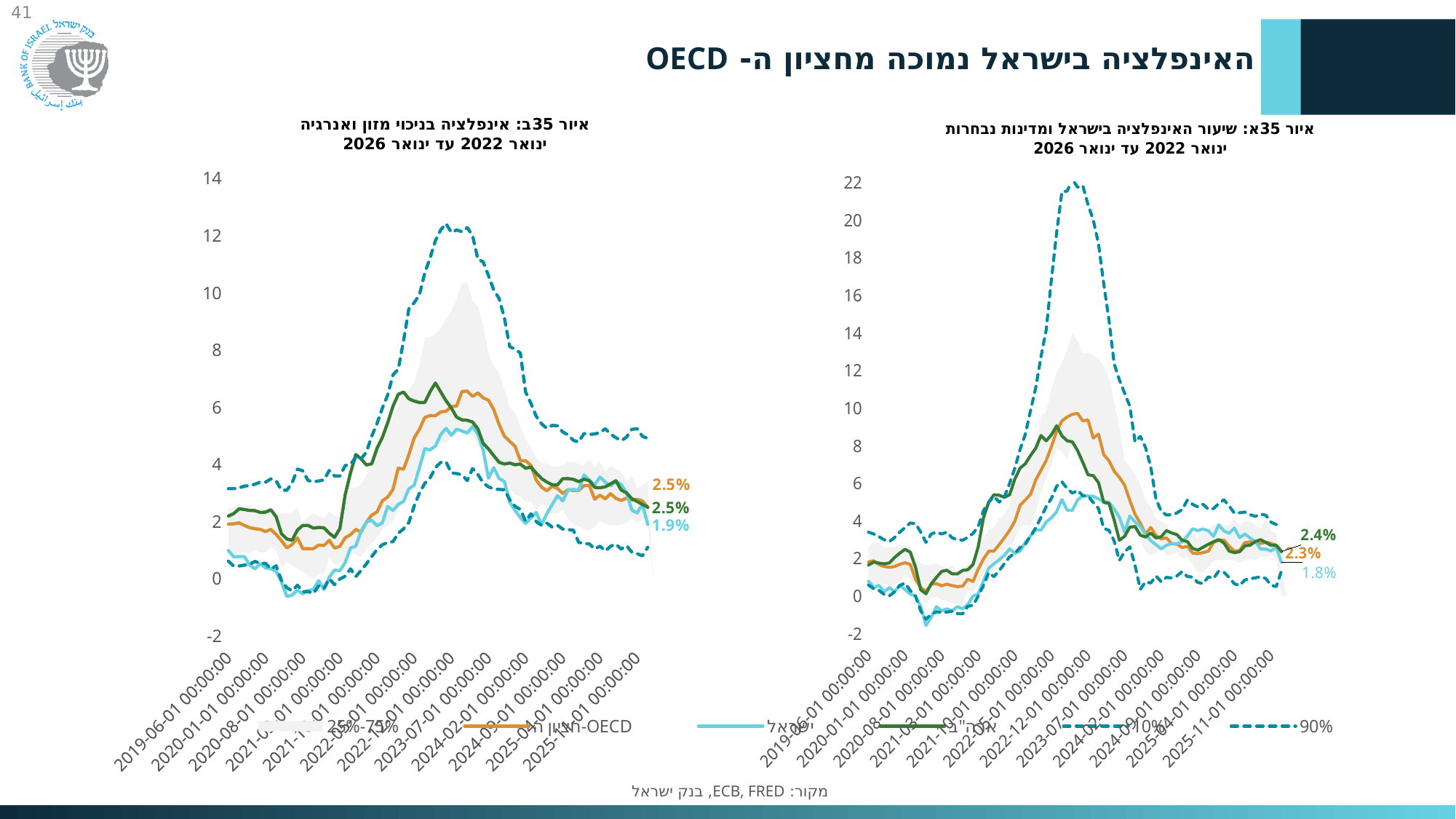
What kind of chart is the right-hand chart (איור 35א)? line chart How many charts are shown on the slide? 2 What is the highest tick value on the y-axis of the right-hand chart (איור 35א)? 22 In the right-hand chart (איור 35א), which of the three end-of-series labels is the lowest? 1.8% (ישראל) In the right-hand chart (איור 35א), what is the difference between the end values for ארה"ב (2.4%) and ישראל (1.8%)? 0.6 percentage points In the right-hand chart (איור 35א), is the peak of the dashed 90% line greater or less than 20? greater In the right-hand chart (איור 35א), what is the latest value labelled for ארה"ב (green line)? 2.4% In the left-hand chart (איור 35ב), what value is labelled at the end of both the orange and the green lines? 2.5% In the right-hand chart (איור 35א), is the end value for ארה"ב or for ישראל larger? ארה"ב In the right-hand chart (איור 35א), what is the latest value labelled in orange at the end of the series? 2.3% In the left-hand chart (איור 35ב), what is the latest value labelled for the light blue line? 1.9% In the right-hand chart (איור 35א), what is the latest value labelled for ישראל (light blue line)? 1.8%